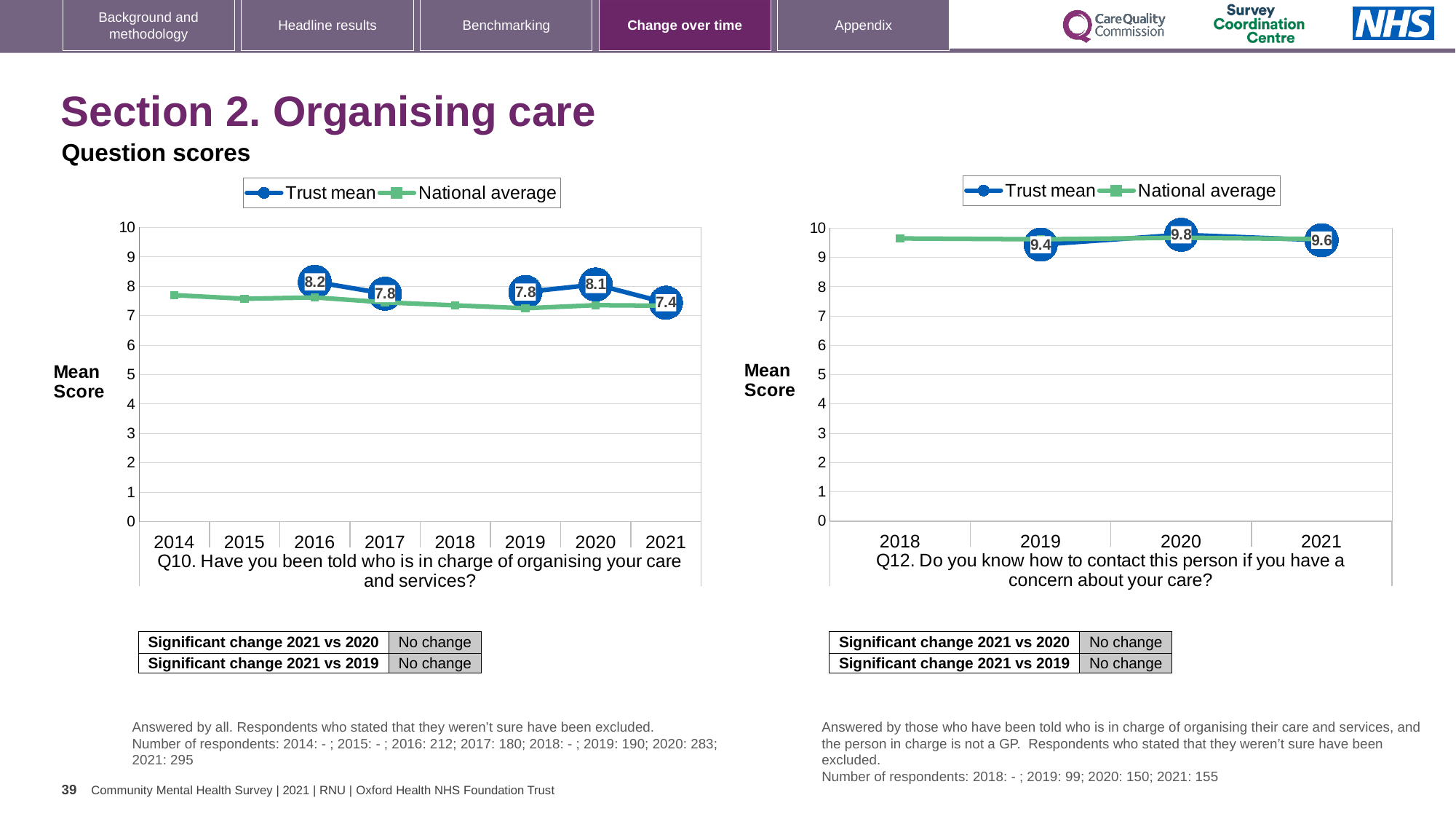
In the Q10 chart on the left, what is the Trust mean for 2021? 7.4 In the Q10 chart on the left, which year has the highest labelled Trust mean? 2016 In the Q10 chart on the left, which year has the lowest labelled Trust mean? 2021 How many series does the legend of the Q12 chart on the right list? 2 In the Q12 chart on the right, is the National average for 2018 greater or less than 9? greater In the Q12 chart on the right, what is the Trust mean for 2020? 9.8 In the Q12 chart on the right, what is the Trust mean for 2019? 9.4 In the Q10 chart on the left, what is the difference between the Trust mean for 2020 and for 2021? 0.7 What type of chart is the Q10 chart on the left? Line chart In the Q10 chart on the left, how many years are shown on the x axis? 8 In the Q10 chart on the left, what is the Trust mean for 2016? 8.2 In the Q12 chart on the right, is the Trust mean for 2021 larger or smaller than the Trust mean for 2019? larger